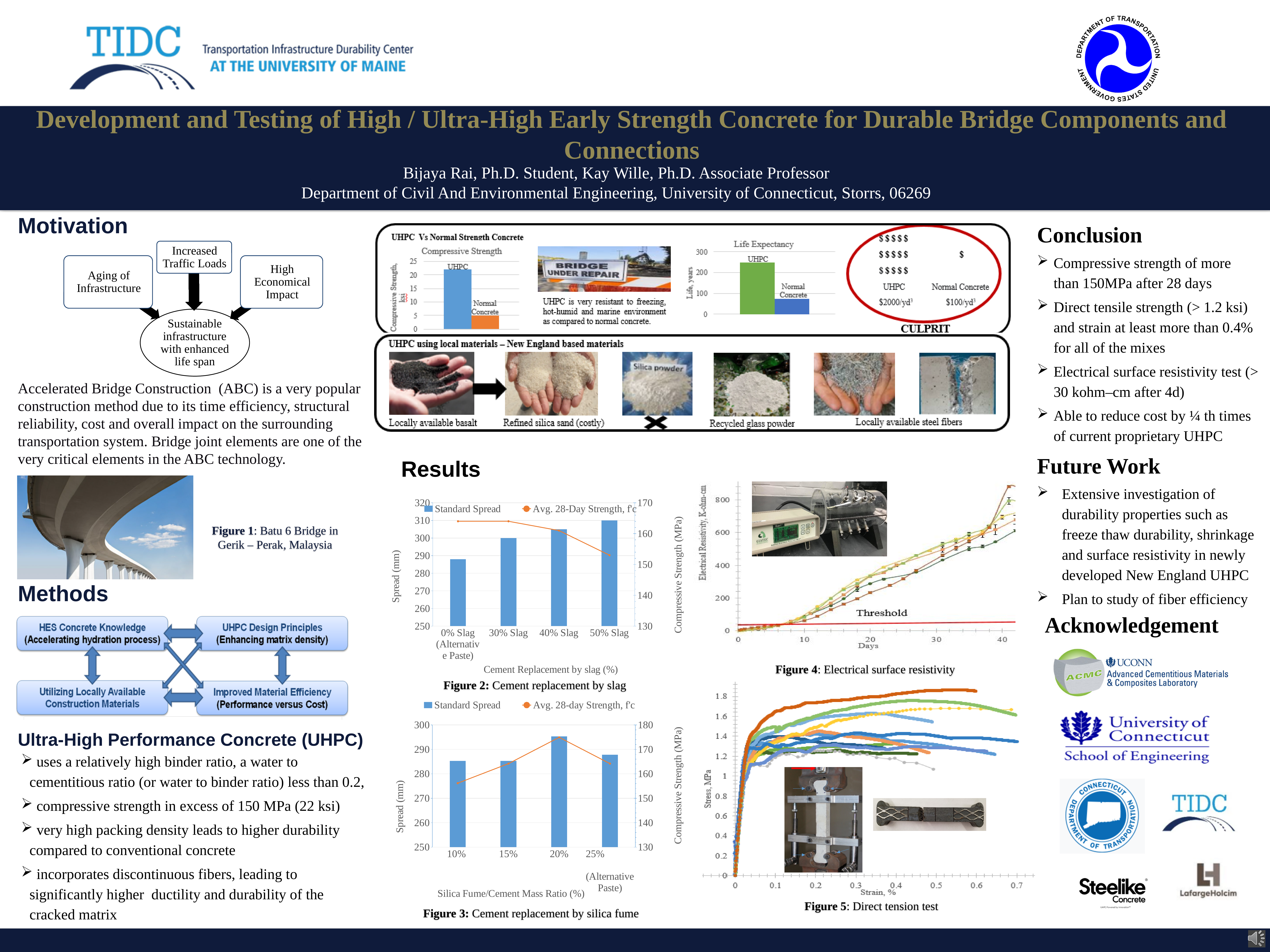
In Figure 2 (Cement replacement by slag), which category has the highest Standard Spread? 50% Slag In the Life Expectancy chart at the top of the slide, which has the higher life expectancy, UHPC or Normal Concrete? UHPC In Figure 2 (Cement replacement by slag), which category has the lowest Standard Spread? 0% Slag (Alternative Paste) In Figure 2 (Cement replacement by slag), does the Standard Spread rise or fall as slag replacement increases from 0% to 50%? rise In Figure 2 (Cement replacement by slag), what kind of chart is used to show the Standard Spread? bar chart In Figure 3 (Cement replacement by silica fume), which is larger, the Avg. 28-day Strength at 10% or at 20%? 20% In Figure 2 (Cement replacement by slag), is the Standard Spread for 50% Slag greater or less than 300 mm? greater In Figure 2 (Cement replacement by slag), is the Avg. 28-Day Strength for 50% Slag greater or less than 160 MPa? less In Figure 3 (Cement replacement by silica fume), is the Avg. 28-day Strength for 20% greater or less than 170 MPa? greater In Figure 2 (Cement replacement by slag), how many series does the legend list? 2 In Figure 3 (Cement replacement by silica fume), which silica fume/cement ratio has the highest Standard Spread? 20% In Figure 2 (Cement replacement by slag), how many slag replacement categories are shown on the x axis? 4